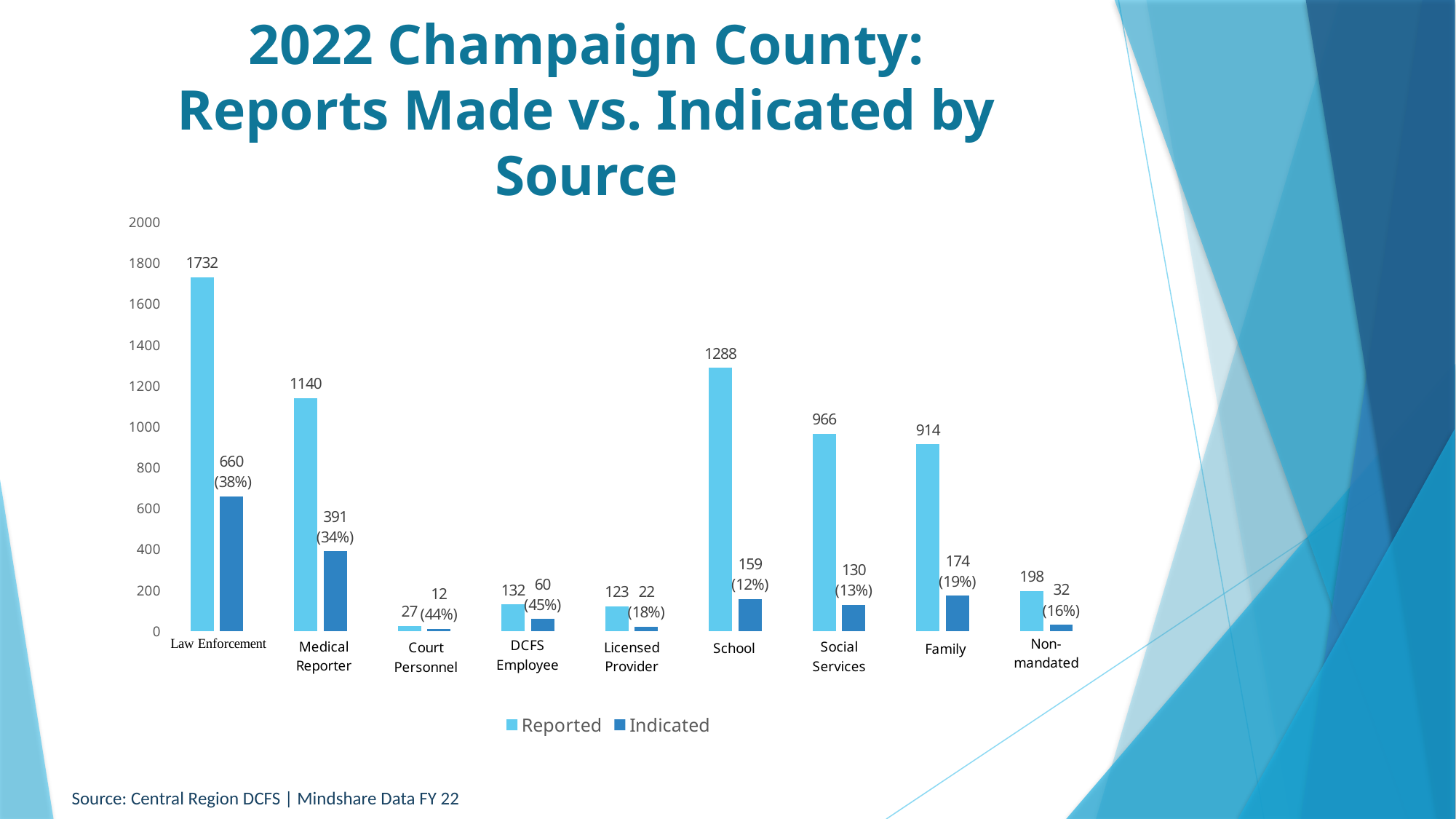
What is the Reported value for Law Enforcement? 1732 How many source categories are shown on the x axis? 9 What is the difference between the Reported and Indicated values for Social Services? 836 Which is larger, the Reported value for Family or the Reported value for Social Services? Social Services What is the Indicated value for Medical Reporter? 391 Is the Reported value for Medical Reporter greater or less than 1000? greater Which source has the highest Reported value? Law Enforcement What is the Reported value for School? 1288 What percentage is shown next to the Indicated value for Family? 19% Which source has the lowest Indicated value? Court Personnel What kind of chart is shown on the slide? Bar chart How many series does the legend list? 2